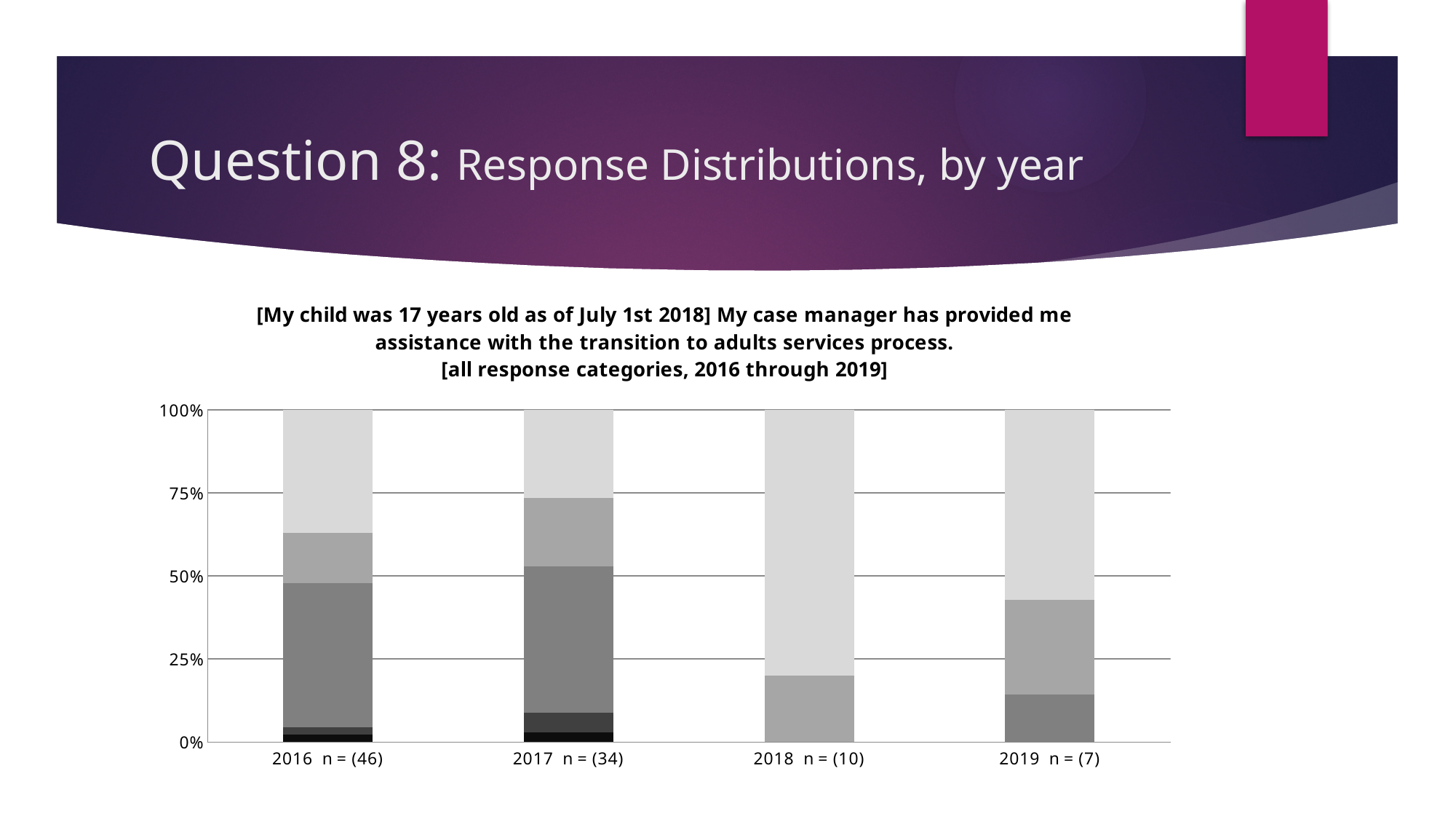
Which year has the smallest sample size n? 2019 In the 2018 bar, is the boundary between the lightest top segment and the segment below it greater or less than 25%? less In the 2016 bar, is the boundary between the lightest top segment and the segment below it greater or less than 50%? greater What range of years does the chart title say the response categories cover? 2016 through 2019 Which year has the largest sample size n? 2016 How many years (bars) are shown on the x axis of the chart? 4 What kind of chart is shown on the slide? Stacked bar chart What is the highest value shown on the y axis of the chart? 100% What is the sample size n shown for 2019? 7 What is the sample size n shown for 2017? 34 Which year has a larger sample size, 2018 or 2019? 2018 What is the difference between the sample sizes for 2016 and 2017? 12